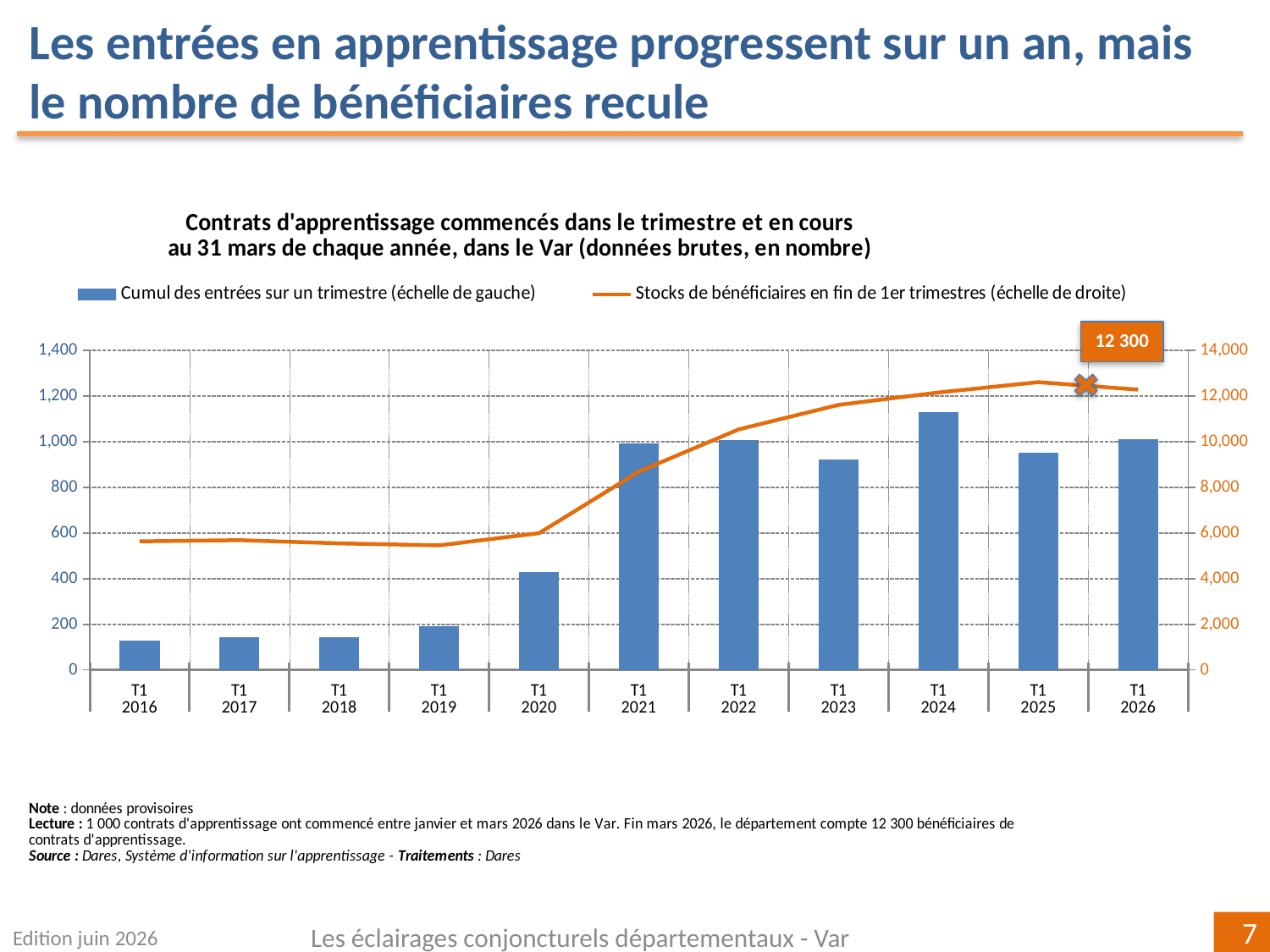
Which bar is taller, T1 2020 or T1 2021? T1 2021 Which quarter has the highest bar for 'Cumul des entrées sur un trimestre'? T1 2024 Is the bar value for T1 2019 greater or less than 400? less What is the value of the stock of beneficiaries (Stocks de bénéficiaires) at T1 2026? 12 300 Is the bar value for T1 2024 greater or less than 1,000? greater What kind of chart is shown? Combined bar and line chart Which bar is taller, T1 2023 or T1 2024? T1 2024 How many quarters are shown on the x axis? 11 Is the stock of beneficiaries at T1 2016 greater or less than 8,000 on the right-hand axis? less Does the line for 'Stocks de bénéficiaires' rise or fall between T1 2020 and T1 2025? Rise How many series does the legend list? 2